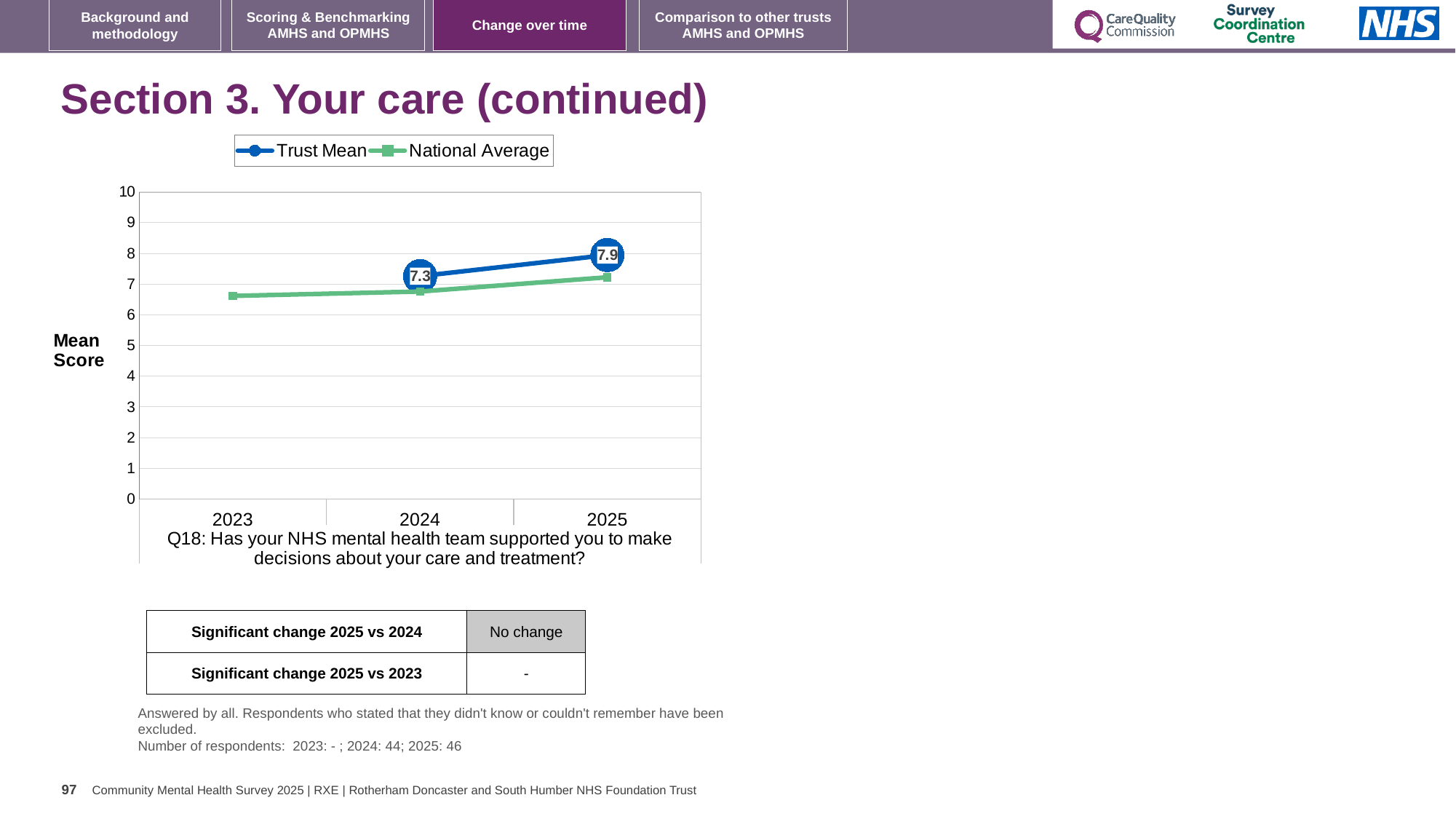
What is the label on the y axis of the chart? Mean Score Which year has the higher Trust Mean score, 2024 or 2025? 2025 Is the National Average value for 2025 greater or less than 8? less How many years are shown on the x axis of the chart? 3 In 2025, which series has the higher value, Trust Mean or National Average? Trust Mean Is the National Average value for 2023 greater or less than 7? less Does the Trust Mean score rise or fall from 2024 to 2025? rise How many series does the legend list? 2 What kind of chart is shown on the slide? line chart What is the Trust Mean score for 2024? 7.3 By how much did the Trust Mean score increase from 2024 to 2025? 0.6 What is the Trust Mean score for 2025? 7.9